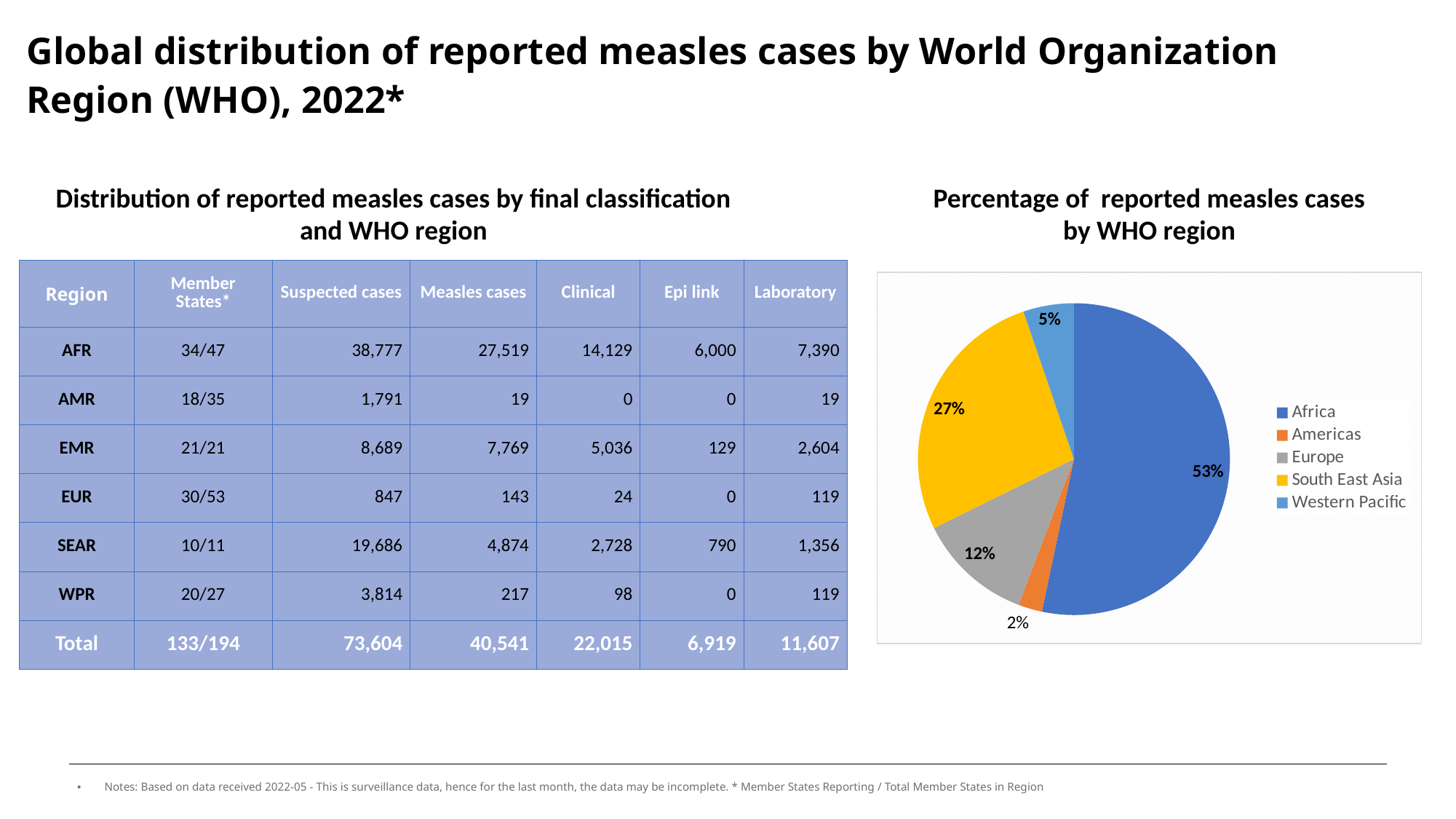
In the pie chart, what colour is the slice for South East Asia? yellow In the pie chart, which has a larger share: Europe or Western Pacific? Europe In the pie chart, what percentage of reported measles cases is attributed to Africa? 53% How many regions does the legend of the pie chart list? 5 In the pie chart, what percentage is shown for Europe? 12% Which region has the smallest slice in the pie chart? Americas In the pie chart, what share of reported measles cases does South East Asia account for? 27% In the pie chart, what percentage is shown for the Americas? 2% In the pie chart, how many percentage points larger is Africa's share than South East Asia's share? 26 In the pie chart, what percentage is shown for the Western Pacific? 5% What type of chart is shown under the title 'Percentage of reported measles cases by WHO region'? pie chart Which region has the largest slice in the pie chart? Africa